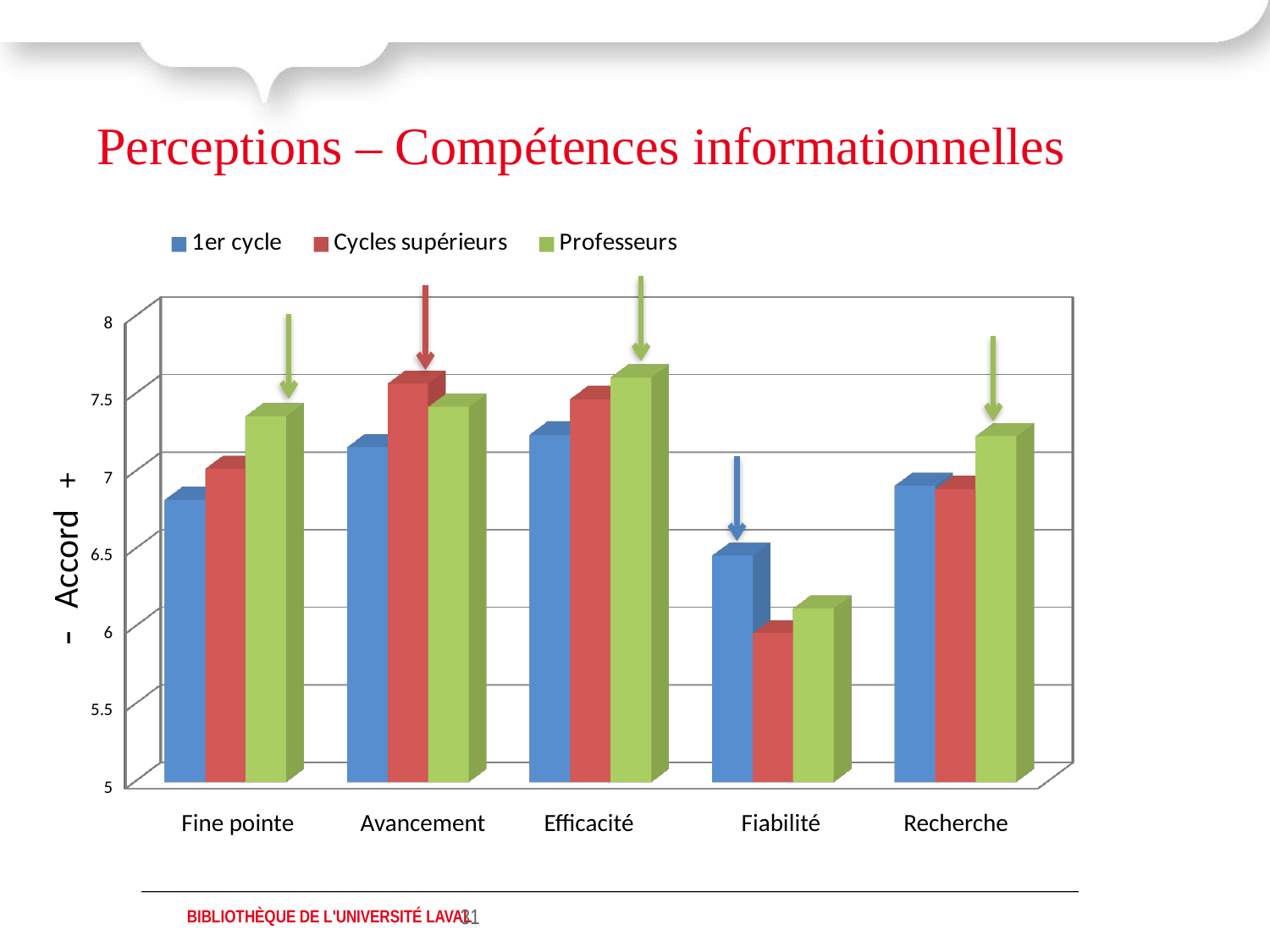
How many series does the legend list? 3 Which series has the lowest bar for Fiabilité? Cycles supérieurs How many categories are shown along the x axis? 5 Is the value for Cycles supérieurs at Fiabilité greater or less than 6.5? less Is the value for 1er cycle at Fiabilité greater or less than 7? less Which series has the highest bar for Fiabilité? 1er cycle Is the value for Professeurs at Recherche greater or less than 7? greater Which series has the highest bar for Fine pointe? Professeurs For Recherche, which is larger: Professeurs or 1er cycle? Professeurs What is the title of the slide containing the chart? Perceptions – Compétences informationnelles What kind of chart is shown on the slide? Bar chart For Avancement, which is larger: 1er cycle or Cycles supérieurs? Cycles supérieurs